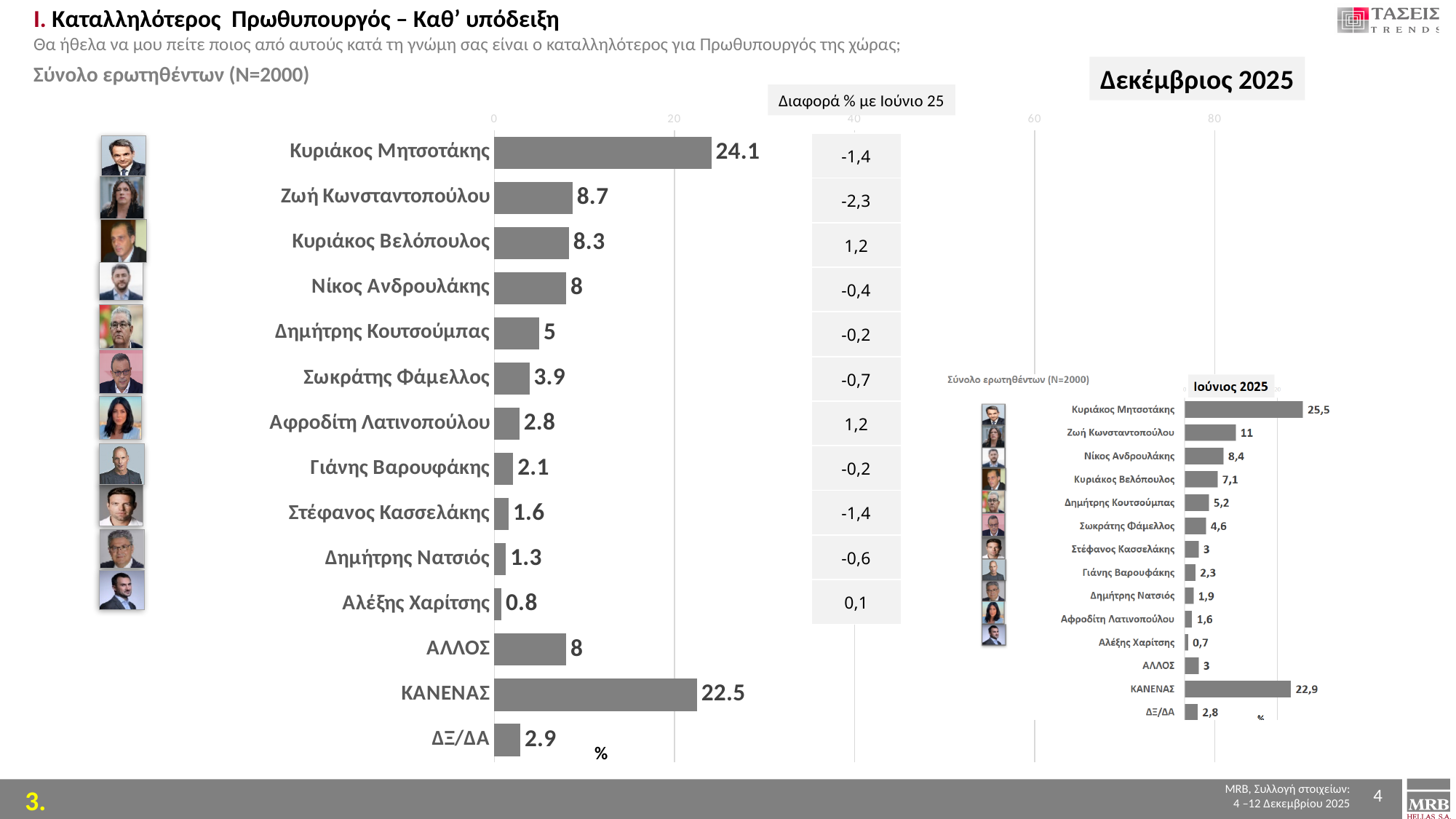
In the Δεκέμβριος 2025 chart, what is the value for Σωκράτης Φάμελλος? 3.9 In the Δεκέμβριος 2025 chart, what is the difference between the values for Κυριάκος Μητσοτάκης and ΚΑΝΕΝΑΣ? 1.6 In the Δεκέμβριος 2025 chart, is the value for Κυριάκος Μητσοτάκης greater or less than 20? greater How many categories are shown in the Δεκέμβριος 2025 chart? 14 What kind of chart is the Δεκέμβριος 2025 chart? bar chart In the Δεκέμβριος 2025 chart, which category has the highest value? Κυριάκος Μητσοτάκης In the Ιούνιος 2025 chart, what is the value for Ζωή Κωνσταντοπούλου? 11 In the Δεκέμβριος 2025 chart, what is the value for ΚΑΝΕΝΑΣ? 22.5 In the Δεκέμβριος 2025 chart, which is larger: the value for Ζωή Κωνσταντοπούλου or for Κυριάκος Βελόπουλος? Ζωή Κωνσταντοπούλου In the Δεκέμβριος 2025 chart, what is the value for Κυριάκος Μητσοτάκης? 24.1 In the Δεκέμβριος 2025 chart, which category has the lowest value? Αλέξης Χαρίτσης In the Ιούνιος 2025 chart, what is the value for ΚΑΝΕΝΑΣ? 22,9